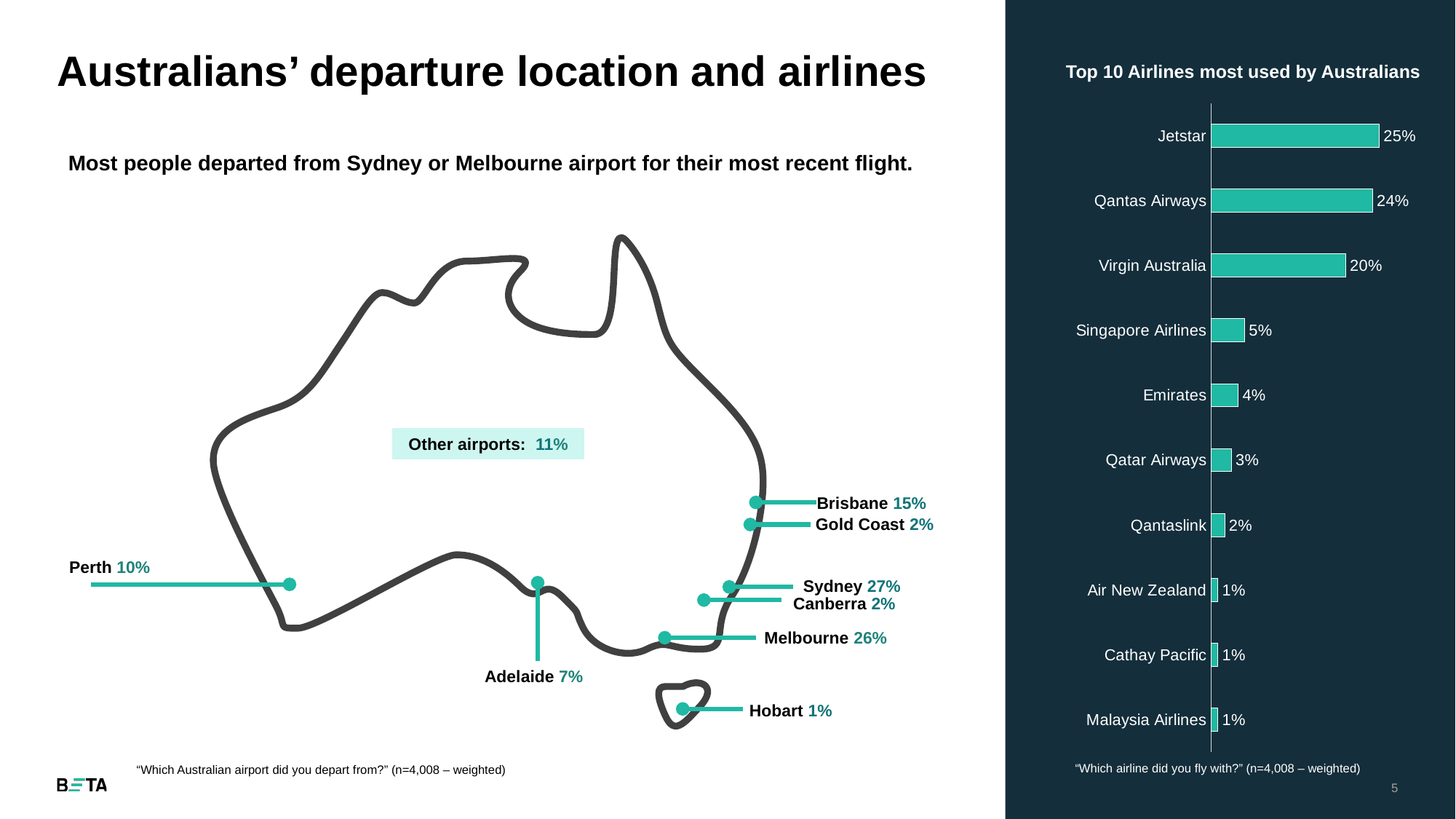
In the 'Top 10 Airlines most used by Australians' chart, what is the value for Qantaslink? 2% In the 'Top 10 Airlines most used by Australians' chart, what is the value for Virgin Australia? 20% On the departure location map, what percentage departed from Sydney? 27% What kind of chart is 'Top 10 Airlines most used by Australians'? Bar chart In the 'Top 10 Airlines most used by Australians' chart, what is the difference between Qantas Airways and Singapore Airlines? 19% In the 'Top 10 Airlines most used by Australians' chart, what is the value for Jetstar? 25% In the 'Top 10 Airlines most used by Australians' chart, which is larger, Emirates or Qatar Airways? Emirates On the departure location map, what percentage is shown for 'Other airports'? 11% On the departure location map, what is the difference between Brisbane and Perth? 5% How many airlines are listed in the 'Top 10 Airlines most used by Australians' chart? 10 On the departure location map, which airport has the lowest percentage? Hobart In the 'Top 10 Airlines most used by Australians' chart, which airline has the highest value? Jetstar